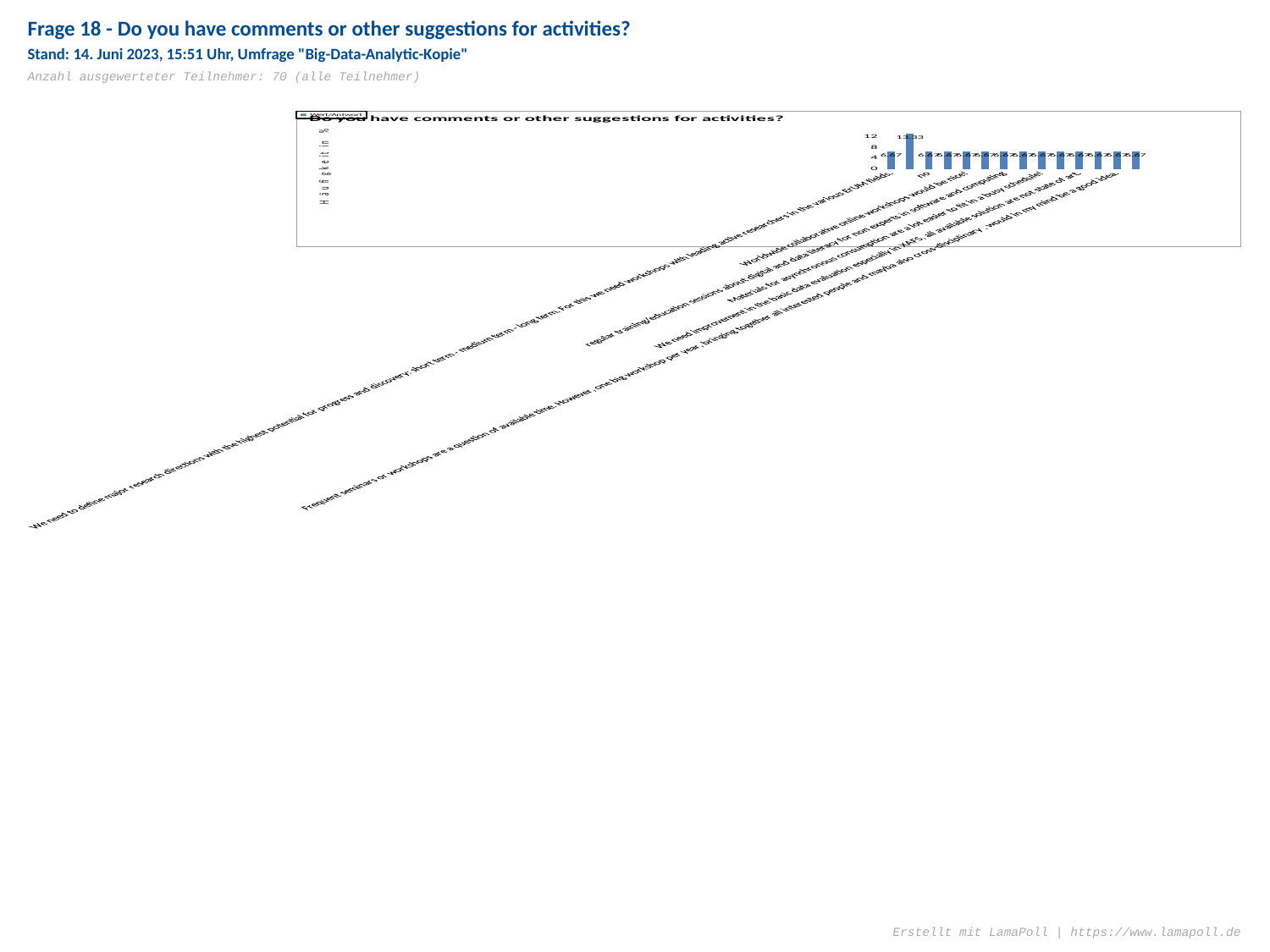
Is the value of the last bar on the right of the chart greater or less than 8? less Is the value of the tallest bar in the chart greater or less than 12? greater What is the label on the vertical axis of the chart? Häufigkeit in % Is the tallest bar in the chart larger than the first bar on the left? yes How many series does the chart's legend list? 1 What kind of chart is shown on the slide? bar chart What is the title of the chart? Do you have comments or other suggestions for activities? Is the value of the first bar on the left of the chart greater or less than 8? less